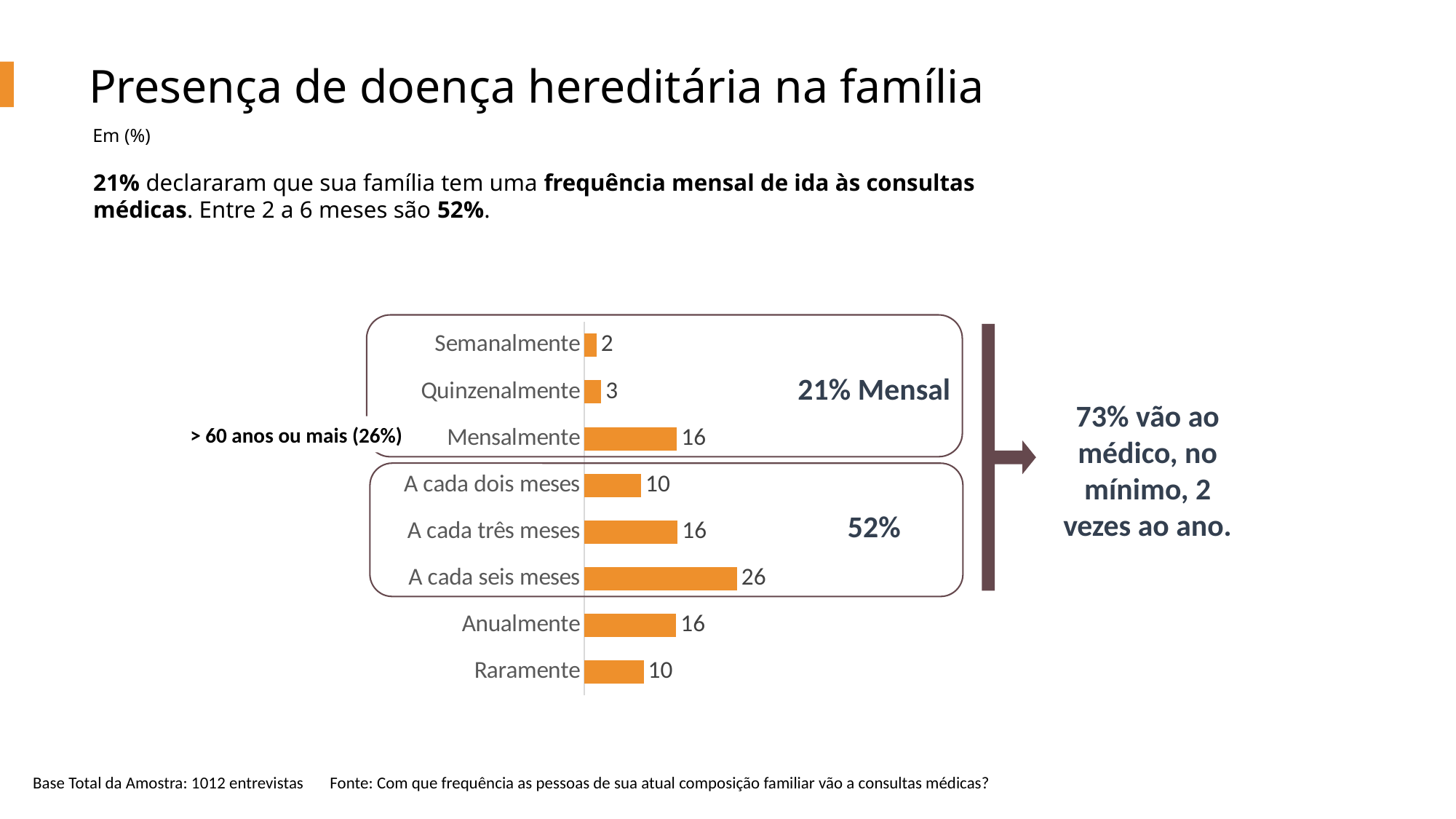
What is the value for Raramente? 10 Which is larger, the value for Quinzenalmente or the value for A cada dois meses? A cada dois meses What is the value for A cada seis meses? 26 What is the difference between the values for A cada seis meses and A cada dois meses? 16 What colour are the bars in the chart? Orange What kind of chart is shown on the slide? Bar chart What is the total of the values for Semanalmente, Quinzenalmente and Mensalmente? 21 What is the value for Mensalmente? 16 Which category has the highest value? A cada seis meses Which category has the lowest value? Semanalmente What is the value for Semanalmente? 2 How many categories are shown in the chart? 8